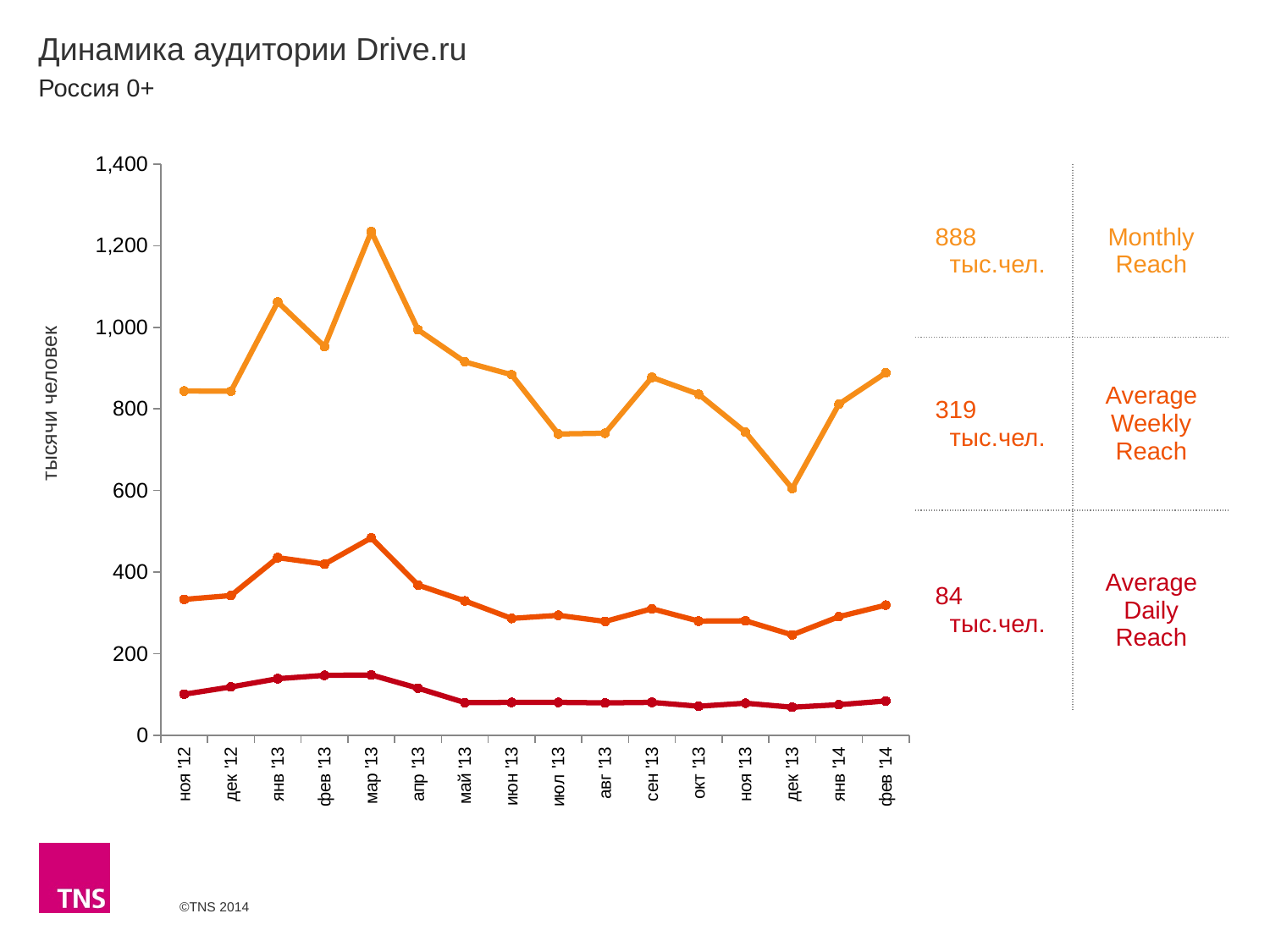
Is the Monthly Reach value for дек '13 greater or less than 800? less What value does the slide give for Average Daily Reach? 84 тыс.чел. How many months are shown along the x axis? 16 In which month does the Monthly Reach line reach its lowest point? дек '13 What kind of chart is shown on the slide? line chart Is the Monthly Reach value for мар '13 greater or less than 1,200? greater In which month does the Monthly Reach line reach its highest point? мар '13 What value does the slide give for Average Weekly Reach? 319 тыс.чел. How many series are plotted on the chart? 3 What is the label on the vertical axis? тысячи человек Which is higher for Monthly Reach: янв '13 or фев '13? янв '13 What value does the slide give for Monthly Reach? 888 тыс.чел.